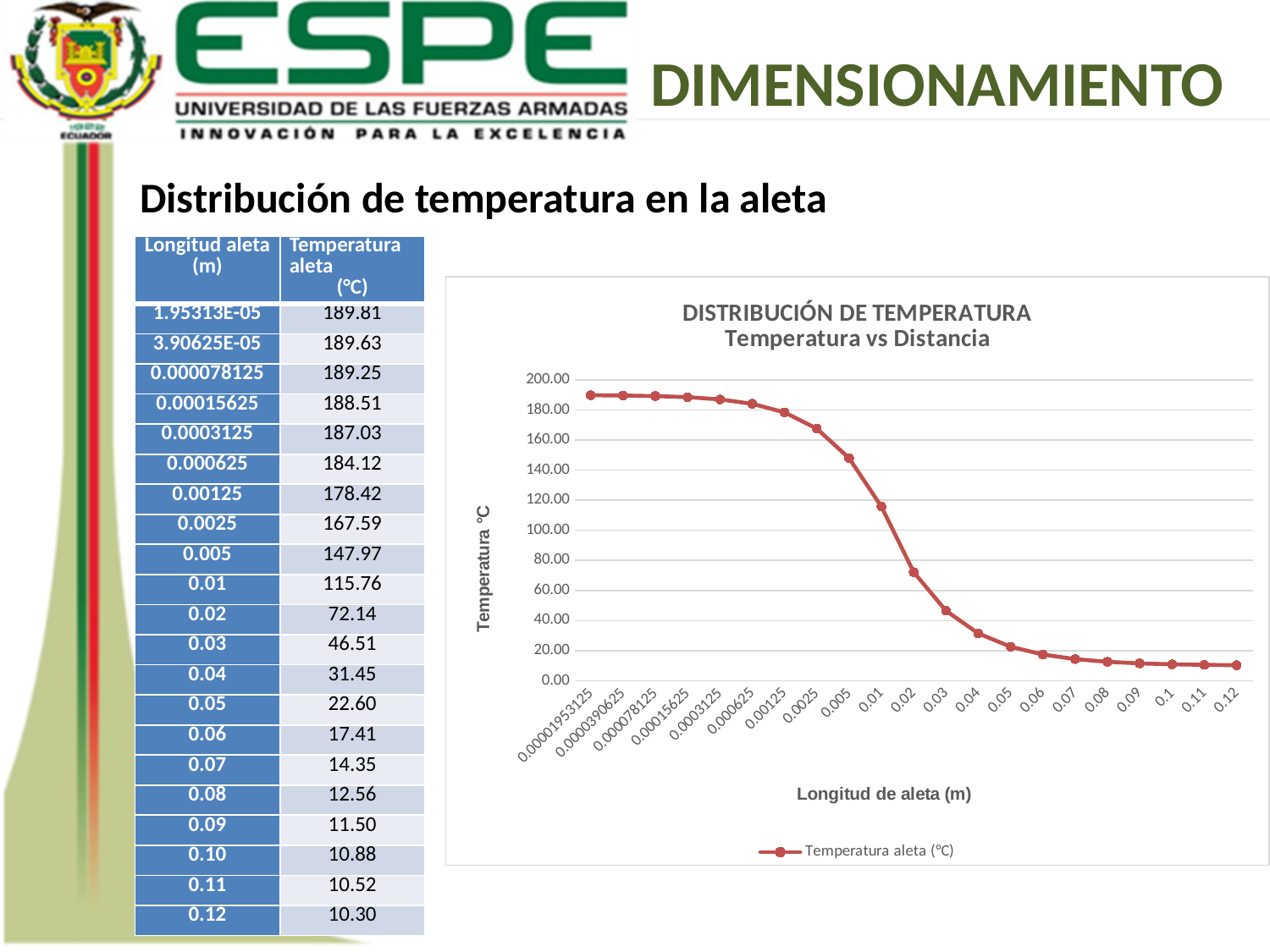
Which has the higher temperature: a fin length of 0.01 m or 0.03 m? 0.01 How many series does the chart legend list? 1 According to the slide, what is the fin temperature at a length of 0.05 m? 22.60 What is the difference between the fin temperature at 0.02 m and at 0.03 m? 25.63 What is the label of the chart's vertical axis? Temperatura °C What kind of chart is shown on the slide? line chart Is the temperature at a fin length of 0.0025 m greater or less than 160.00? greater Does the temperature rise or fall as the fin length increases along the x axis? fall Is the temperature at a fin length of 0.005 m greater or less than 140.00? greater Is the temperature at a fin length of 0.02 m greater or less than 80.00? less How many data points are plotted on the chart? 21 What is the name of the series shown in the chart legend? Temperatura aleta (°C)